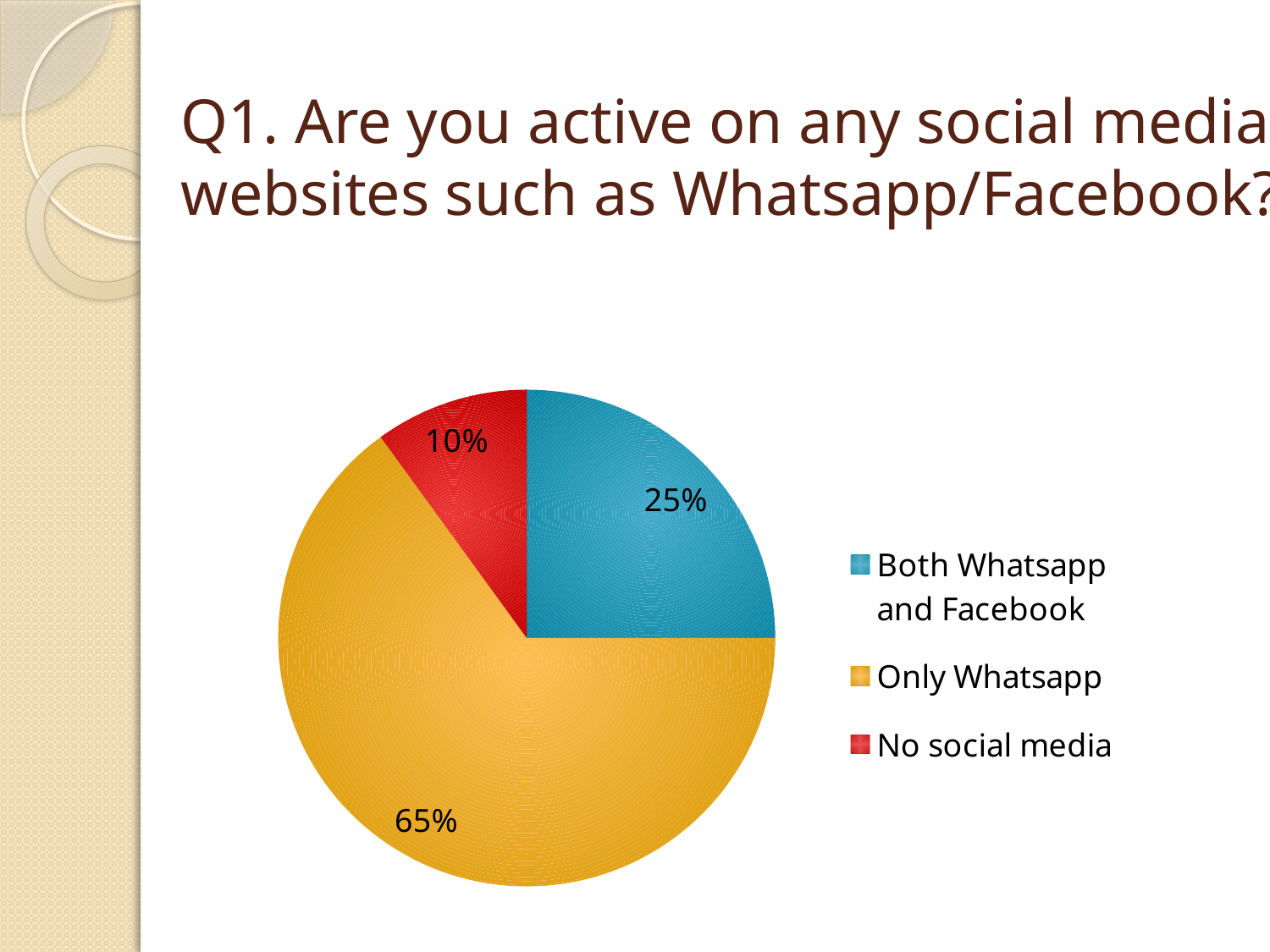
What share of the pie is labelled for Only Whatsapp? 65% What share of the pie is labelled for Both Whatsapp and Facebook? 25% How many slices does the pie chart have? 3 What is the difference in percentage points between Only Whatsapp and Both Whatsapp and Facebook? 40% Which category has the largest slice of the pie? Only Whatsapp What kind of chart is shown on the slide? Pie chart Which category is shown in red in the legend? No social media What is the difference in percentage points between Both Whatsapp and Facebook and No social media? 15% What colour is the slice for Only Whatsapp? Yellow Which is larger, the slice for Both Whatsapp and Facebook or the slice for No social media? Both Whatsapp and Facebook Which category has the smallest slice of the pie? No social media What share of the pie is labelled for No social media? 10%